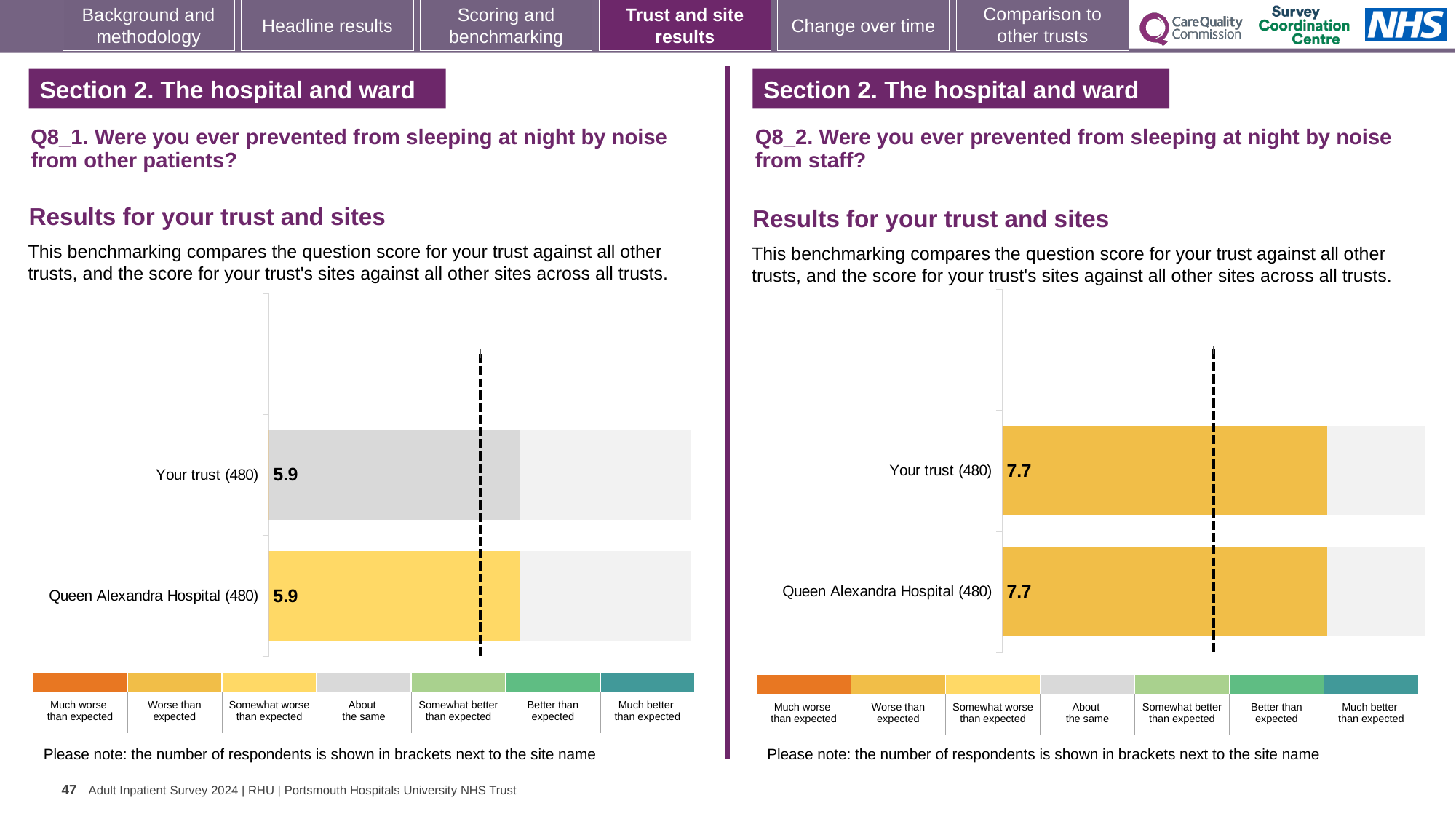
On the Q8_1 chart (left), which benchmark category does the colour of the Your trust bar correspond to in the key? About the same How many bars are plotted on the Q8_1 chart (left)? 2 On the Q8_2 chart (right), what is the score for Queen Alexandra Hospital (480)? 7.7 On the Q8_2 chart (right), what is the difference between the score for Your trust and the score for Queen Alexandra Hospital? 0.0 On the Q8_1 chart (left), what is the score for Your trust (480)? 5.9 What kind of chart is the Q8_1 chart (left)? Bar chart On the Q8_2 chart (right), what is the score for Your trust (480)? 7.7 On the Q8_1 chart (left), what is the score for Queen Alexandra Hospital (480)? 5.9 On the Q8_1 chart (left), what is the difference between the score for Your trust and the score for Queen Alexandra Hospital? 0.0 How many bars are plotted on the Q8_2 chart (right)? 2 How many respondents are shown in brackets for Queen Alexandra Hospital on the Q8_1 chart (left)? 480 Is the Your trust score on the Q8_2 chart (right) larger or smaller than the Your trust score on the Q8_1 chart (left)? Larger